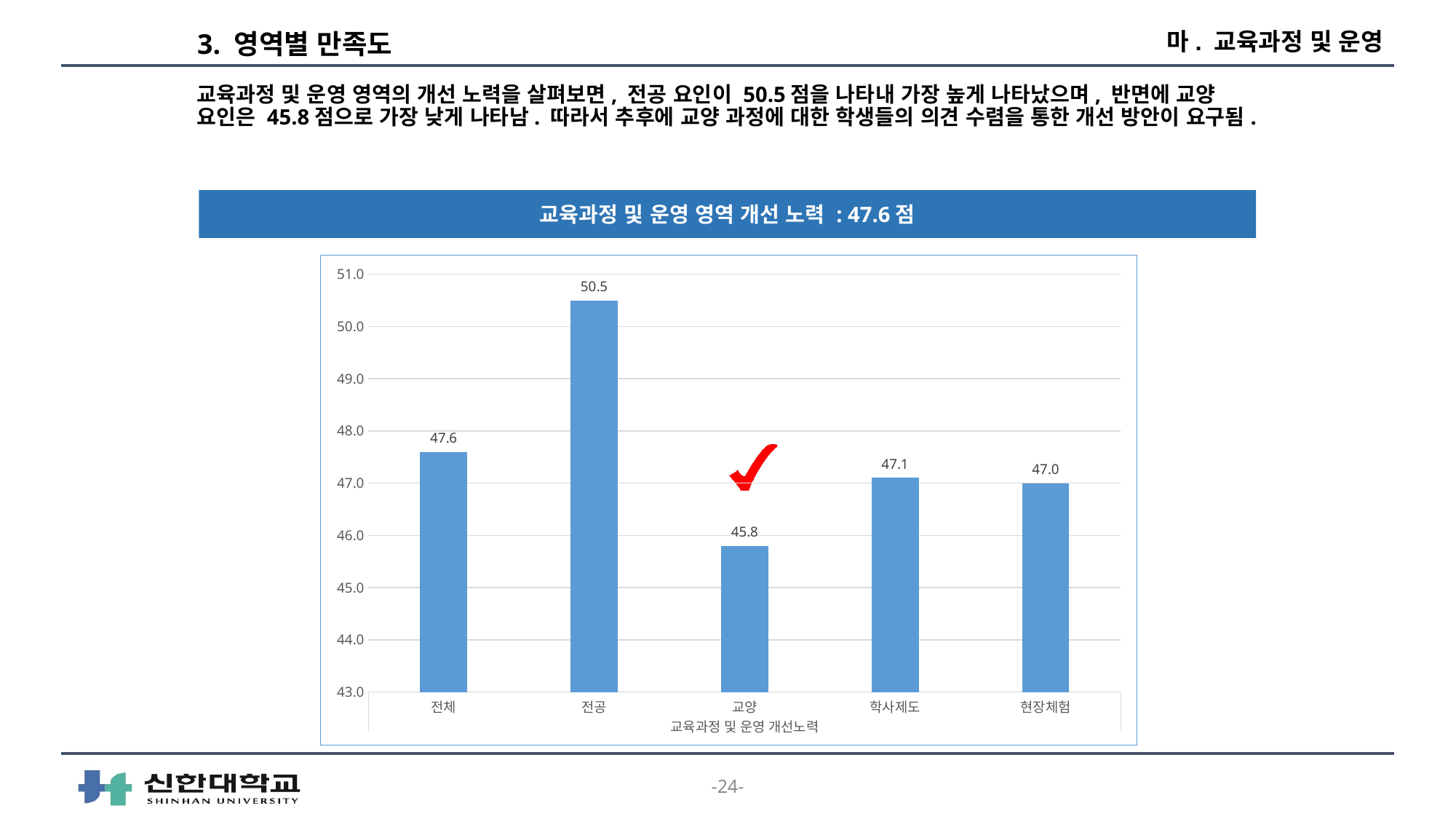
Which category has the lowest value? 교양 What is the difference between the values for 전공 and 교양? 4.7 Which category has the highest value? 전공 What kind of chart is shown on the slide? bar chart What is the value for 현장체험? 47.0 What is the difference between the values for 전체 and 학사제도? 0.5 What is the value for 전공? 50.5 How many categories are shown on the x axis? 5 What is the value for 학사제도? 47.1 Which is larger, the value for 전체 or the value for 현장체험? 전체 What is the value for 교양? 45.8 Is the value for 교양 greater or less than 46.0? less